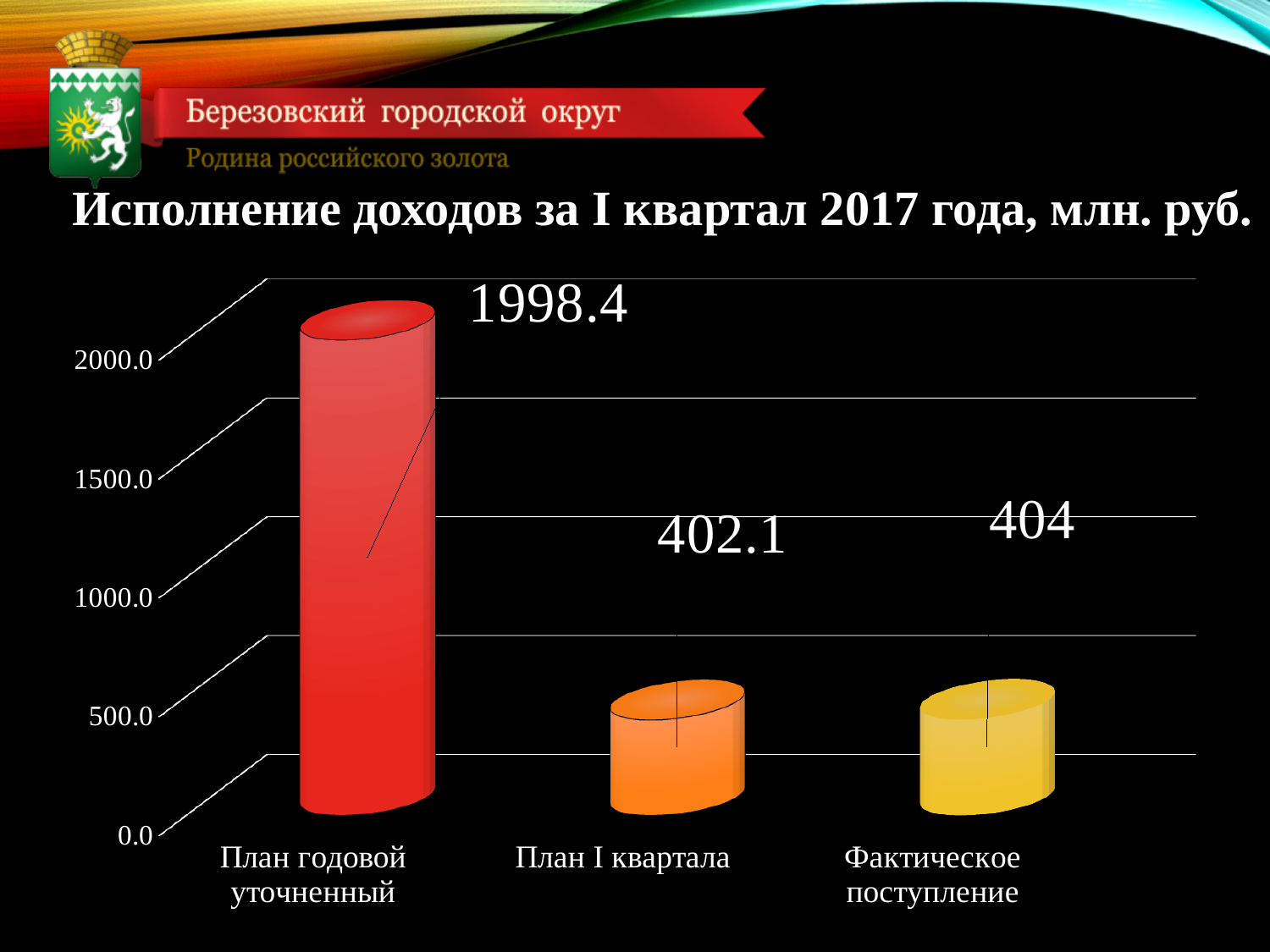
What is the value for План I квартала? 402.1 What is the value for План годовой уточненный? 1998.4 Which is larger, Фактическое поступление or План I квартала? Фактическое поступление What is the difference between Фактическое поступление and План I квартала? 1.9 Is the value for План I квартала greater or less than 500.0? less How many categories are shown on the x axis? 3 What is the difference between План годовой уточненный and План I квартала? 1596.3 What is the value for Фактическое поступление? 404 What kind of chart is shown on the slide? bar chart What is the title of the chart? Исполнение доходов за I квартал 2017 года, млн. руб. Which category has the highest value? План годовой уточненный Which category has the lowest value? План I квартала